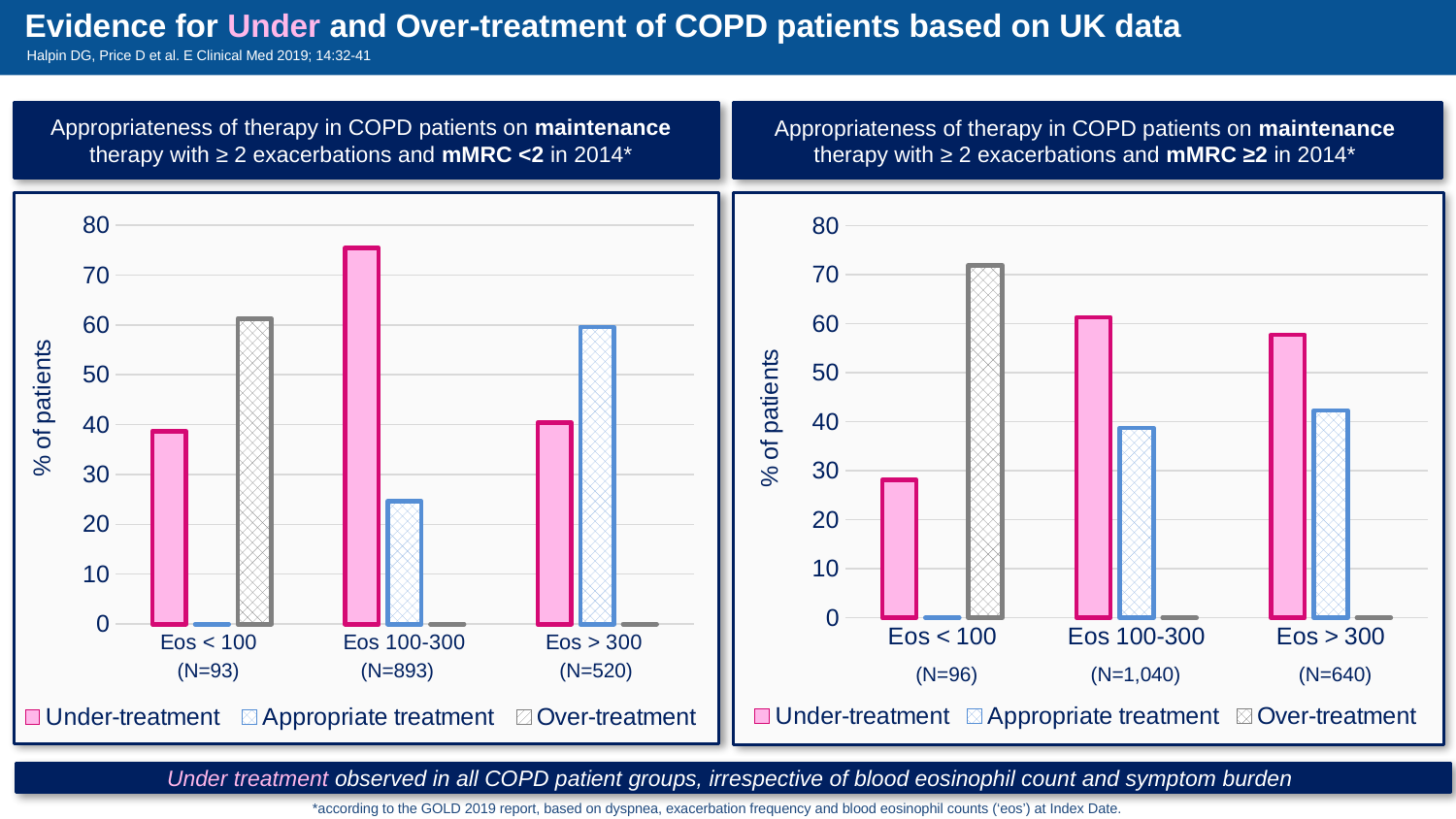
How many eosinophil categories are shown on the x axis of the left chart (mMRC <2)? 3 In the left chart (mMRC <2), is the Under-treatment value for Eos 100-300 greater or less than 70? greater What is the y-axis label of the right chart (mMRC ≥2)? % of patients In the left chart (mMRC <2), which eosinophil category has the highest Under-treatment value? Eos 100-300 In the right chart (mMRC ≥2), is the Over-treatment value for Eos < 100 greater or less than 70? greater In the left chart (mMRC <2), for Eos > 300, which is larger: Under-treatment or Appropriate treatment? Appropriate treatment In the left chart (mMRC <2), is the Appropriate treatment value for Eos 100-300 greater or less than 30? less What kind of chart is the left chart (mMRC <2)? bar chart In the right chart (mMRC ≥2), for Eos 100-300, which is larger: Under-treatment or Appropriate treatment? Under-treatment In the right chart (mMRC ≥2), which eosinophil category has the lowest Under-treatment value? Eos < 100 How many series does the legend of the right chart (mMRC ≥2) list? 3